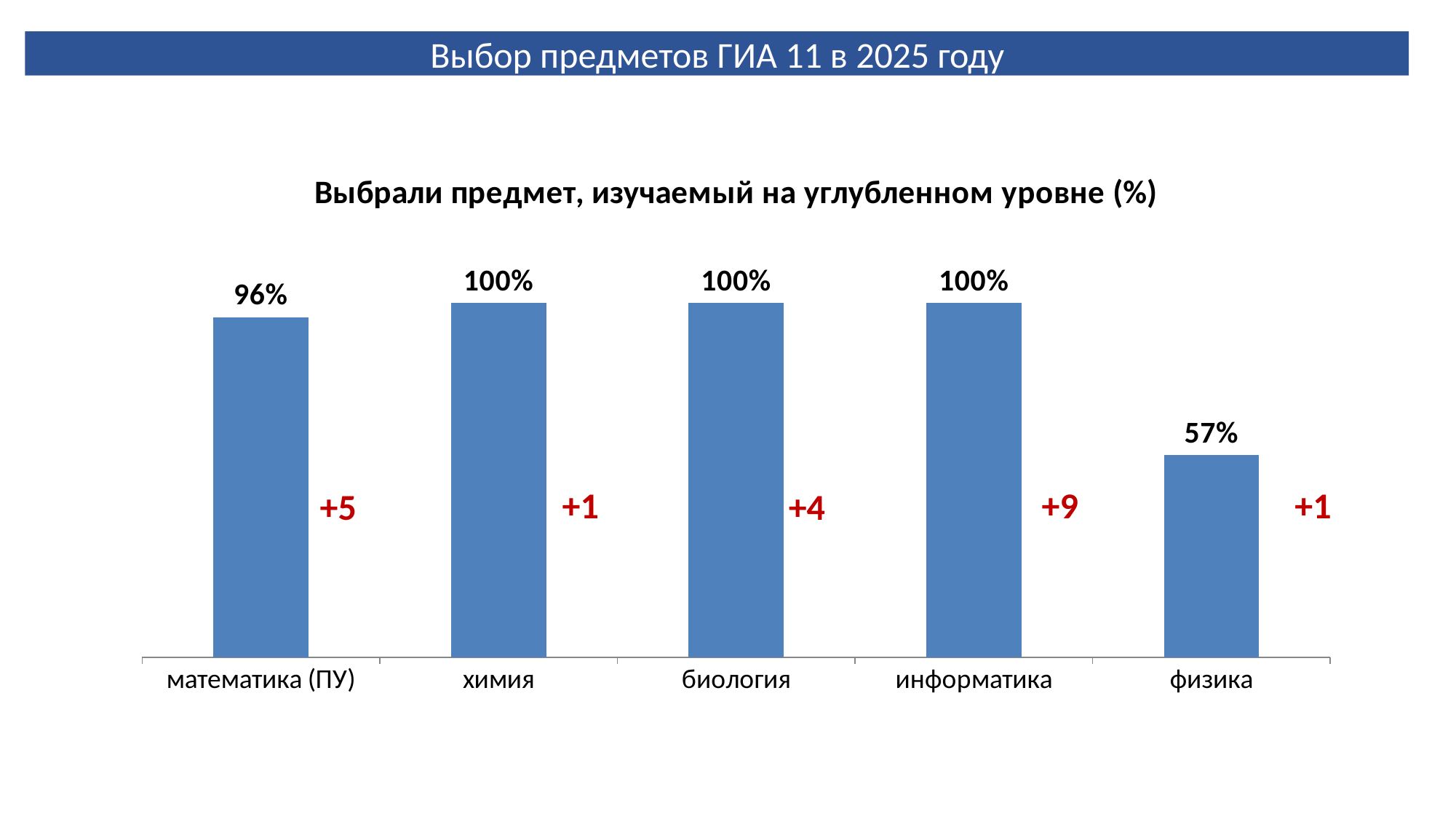
What red annotation is shown next to the bar for информатика? +9 What kind of chart is shown on the slide? bar chart What is the value for химия? 100% What is the value for физика? 57% How many categories are shown on the chart? 5 What is the difference between the values for математика (ПУ) and физика? 39% How many categories have a value of 100%? 3 Which is larger, the value for информатика or the value for физика? информатика Which category has the lowest value? физика What is the value for математика (ПУ)? 96% What is the title of the chart? Выбрали предмет, изучаемый на углубленном уровне (%) What is the difference between the values for биология and математика (ПУ)? 4%